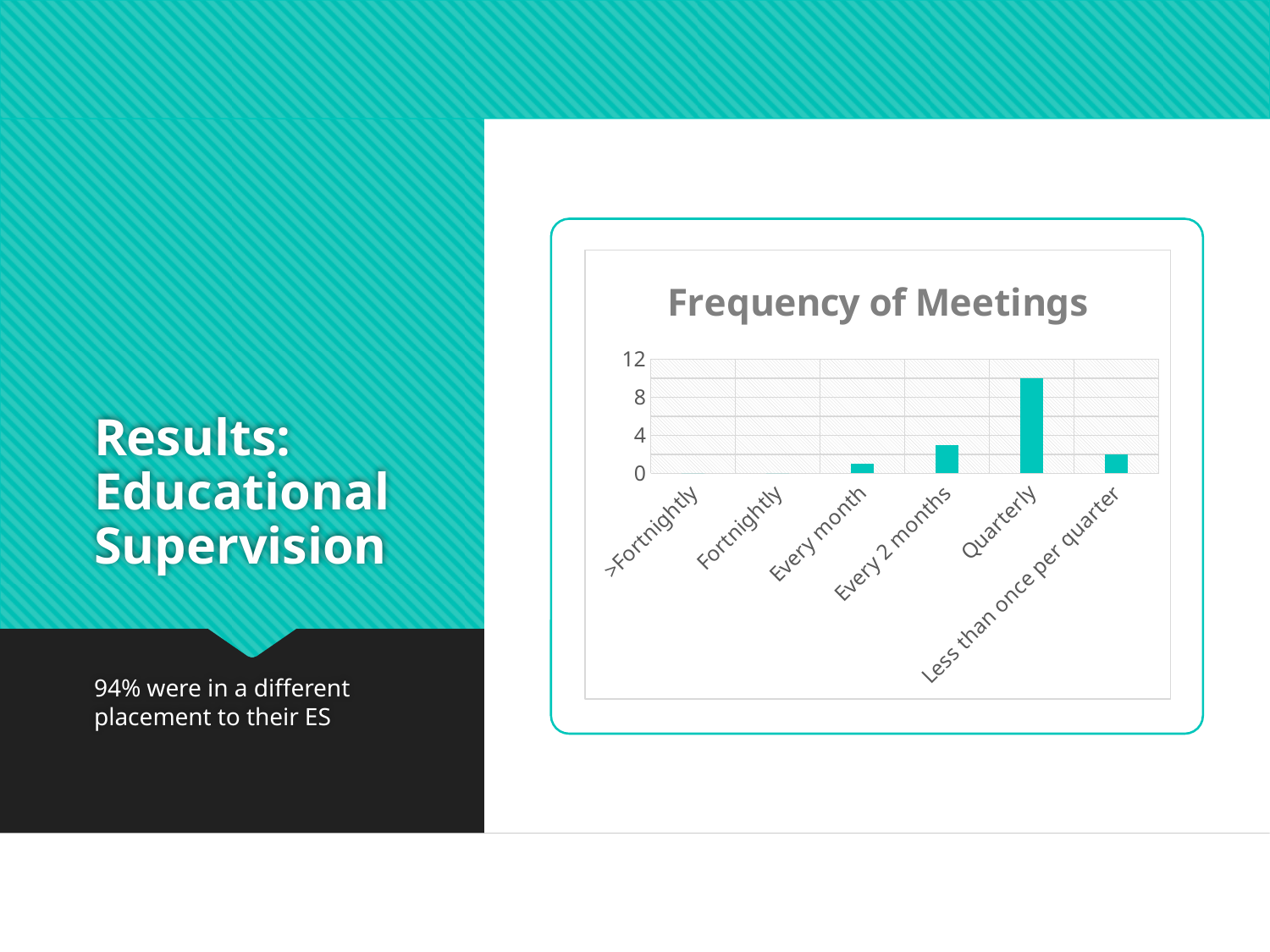
Which is larger, the value for Quarterly or the value for Every 2 months? Quarterly How many categories are shown on the x axis of the chart? 6 What is the title of the chart? Frequency of Meetings Is the value for Quarterly greater or less than 8? greater What is the value for Fortnightly in the chart? 0 What type of chart is shown on the slide? bar chart Which is larger, the value for Every 2 months or the value for Every month? Every 2 months Is the value for Every month greater or less than 4? less Which category has the highest value in the chart? Quarterly How many categories in the chart have no visible bar (a value of 0)? 2 Is the value for Less than once per quarter greater or less than 4? less